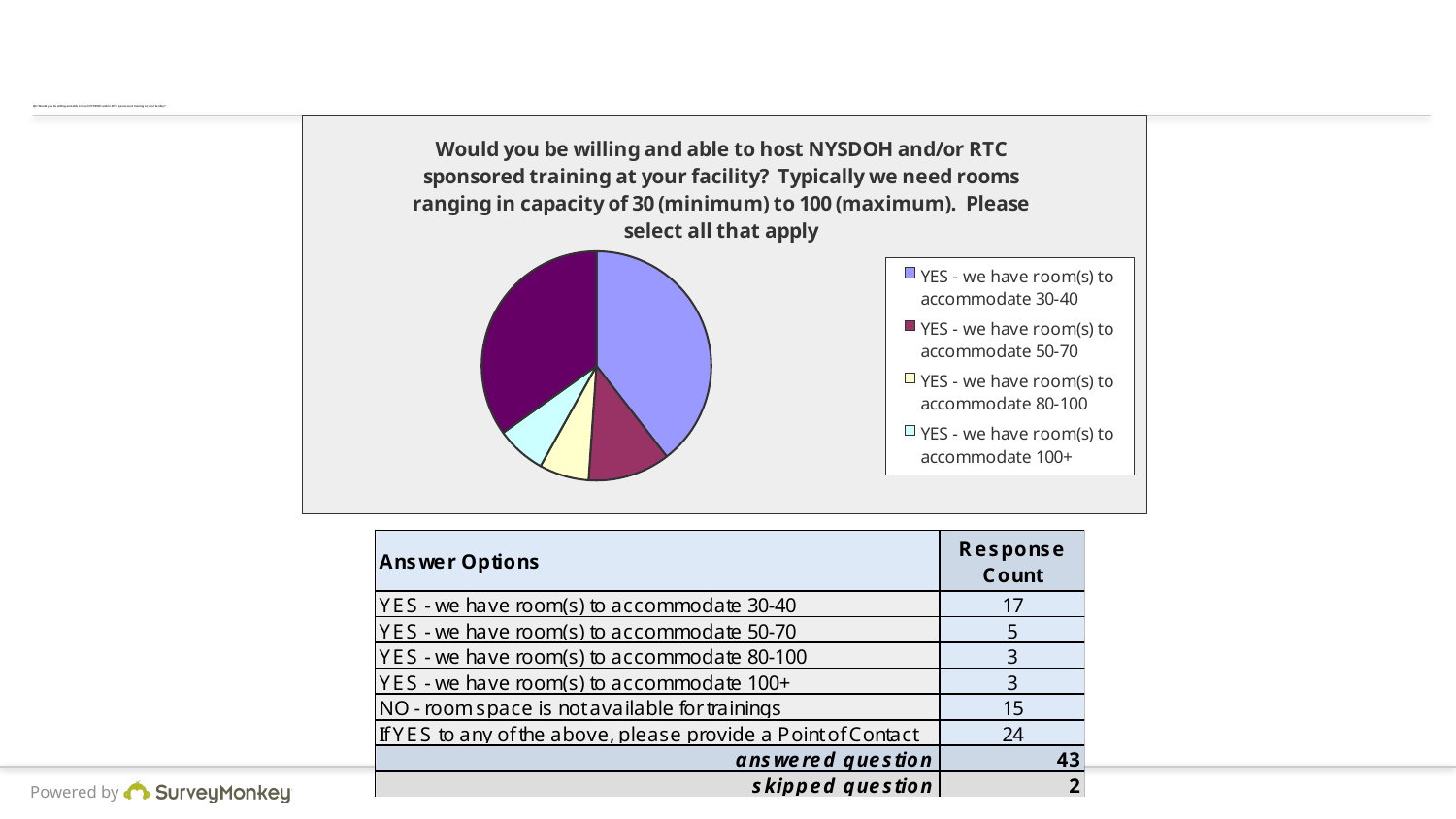
What is the response count for "YES - we have room(s) to accommodate 80-100"? 3 Which has the larger response count: "YES - we have room(s) to accommodate 30-40" or "YES - we have room(s) to accommodate 50-70"? YES - we have room(s) to accommodate 30-40 Which legend entry corresponds to the largest slice of the pie? YES - we have room(s) to accommodate 30-40 How many slices does the pie chart have? 5 What is the response count for "NO - room space is not available for trainings"? 15 What is the response count for "YES - we have room(s) to accommodate 30-40"? 17 What colour is the slice for "YES - we have room(s) to accommodate 50-70"? maroon How many entries does the chart's legend list? 4 What kind of chart is shown on the slide? pie chart How many respondents answered the question, according to the table? 43 What is the difference between the response counts for "YES - we have room(s) to accommodate 30-40" and "YES - we have room(s) to accommodate 50-70"? 12 What is the response count for "YES - we have room(s) to accommodate 50-70"? 5